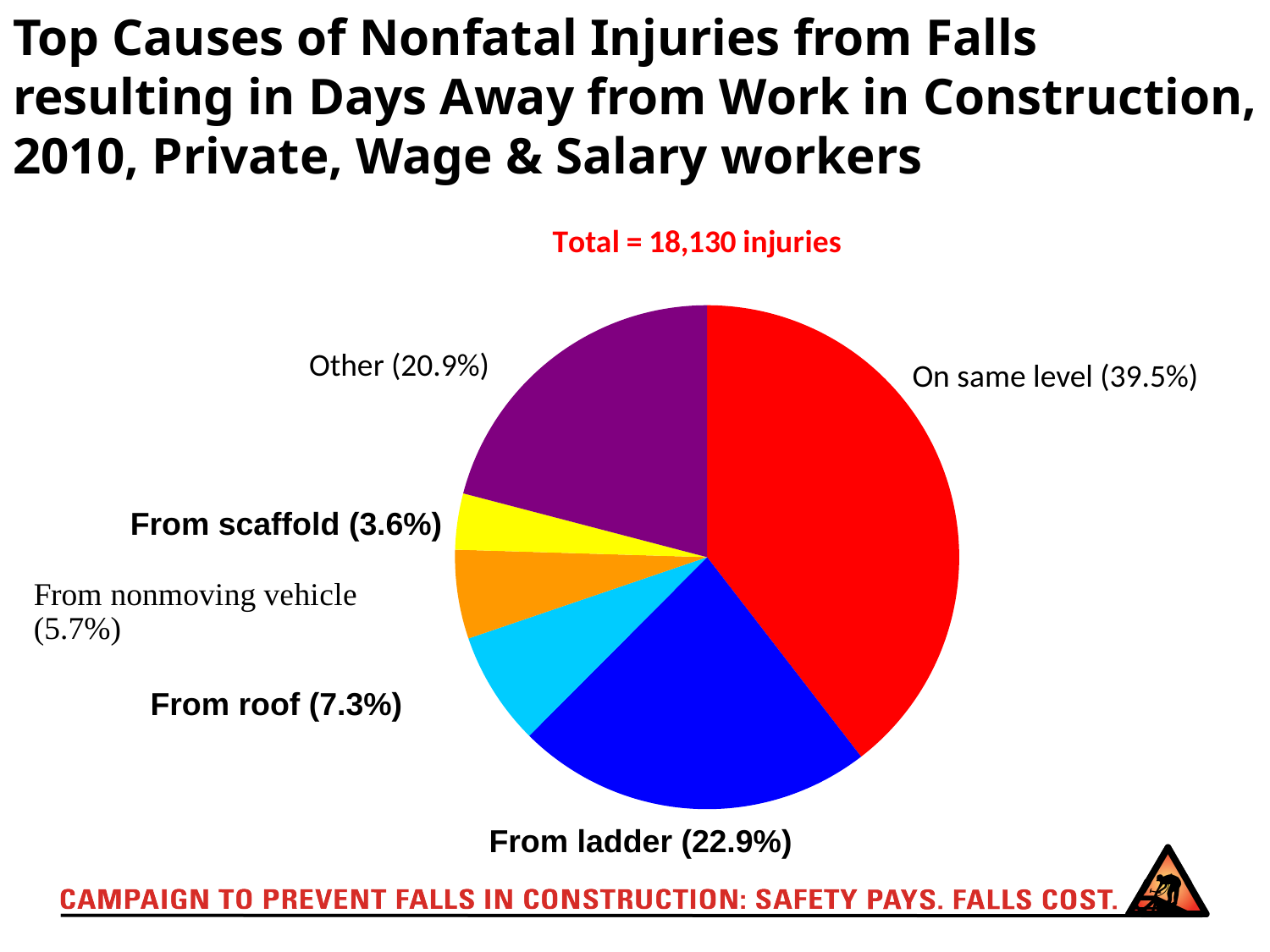
What share of injuries is from falls from a roof? 7.3% Which has a larger share: falls from a roof or falls from a nonmoving vehicle? From roof What share of injuries is from falls from scaffold? 3.6% Which cause of fall injuries has the largest share of the pie? On same level What is the difference in percentage points between falls on the same level and falls from a ladder? 16.6 What kind of chart is shown on the slide? Pie chart What percentage of injuries is from falls from a ladder? 22.9% Which cause of fall injuries has the smallest share of the pie? From scaffold What share of nonfatal fall injuries is attributed to falls on the same level? 39.5% What percentage is shown for falls from a nonmoving vehicle? 5.7% How many slices does the pie chart have? 6 What total number of injuries is stated above the pie chart? 18,130 injuries